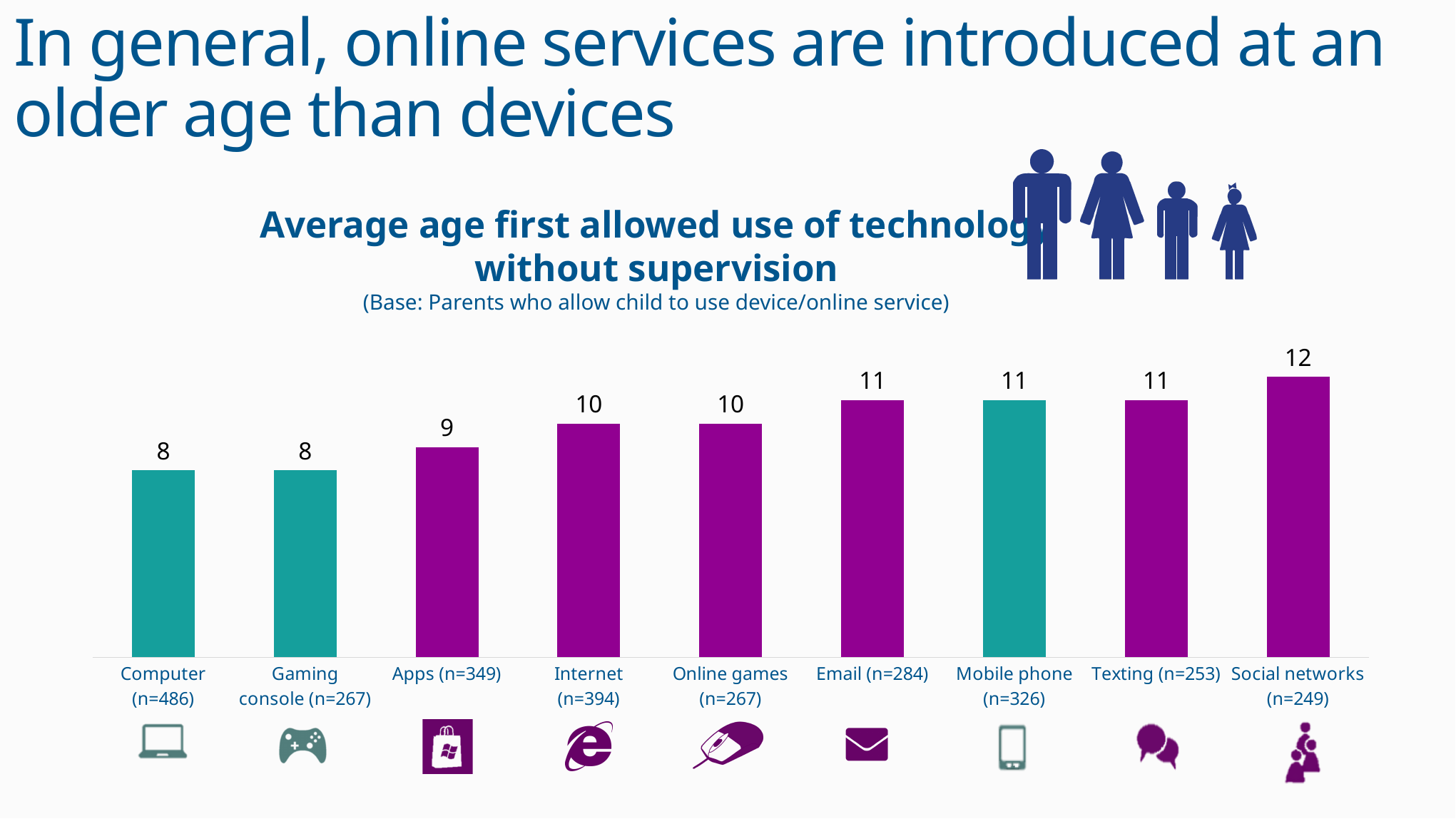
What is the average age first allowed to use a computer without supervision? 8 What kind of chart is shown on the slide? Bar chart Do the values generally rise or fall from left to right across the categories? Rise What is the value shown for Mobile phone (n=326)? 11 Which is larger, the value for Internet or the value for Gaming console? Internet What is the difference between the value for Social networks and the value for Computer? 4 How many categories are shown on the chart? 9 What is the title of the chart? Average age first allowed use of technology without supervision Which category has the highest average age? Social networks (n=249) What is the average age first allowed to use social networks without supervision? 12 What is the difference between the value for Email and the value for Apps? 2 What is the value shown for Apps (n=349)? 9